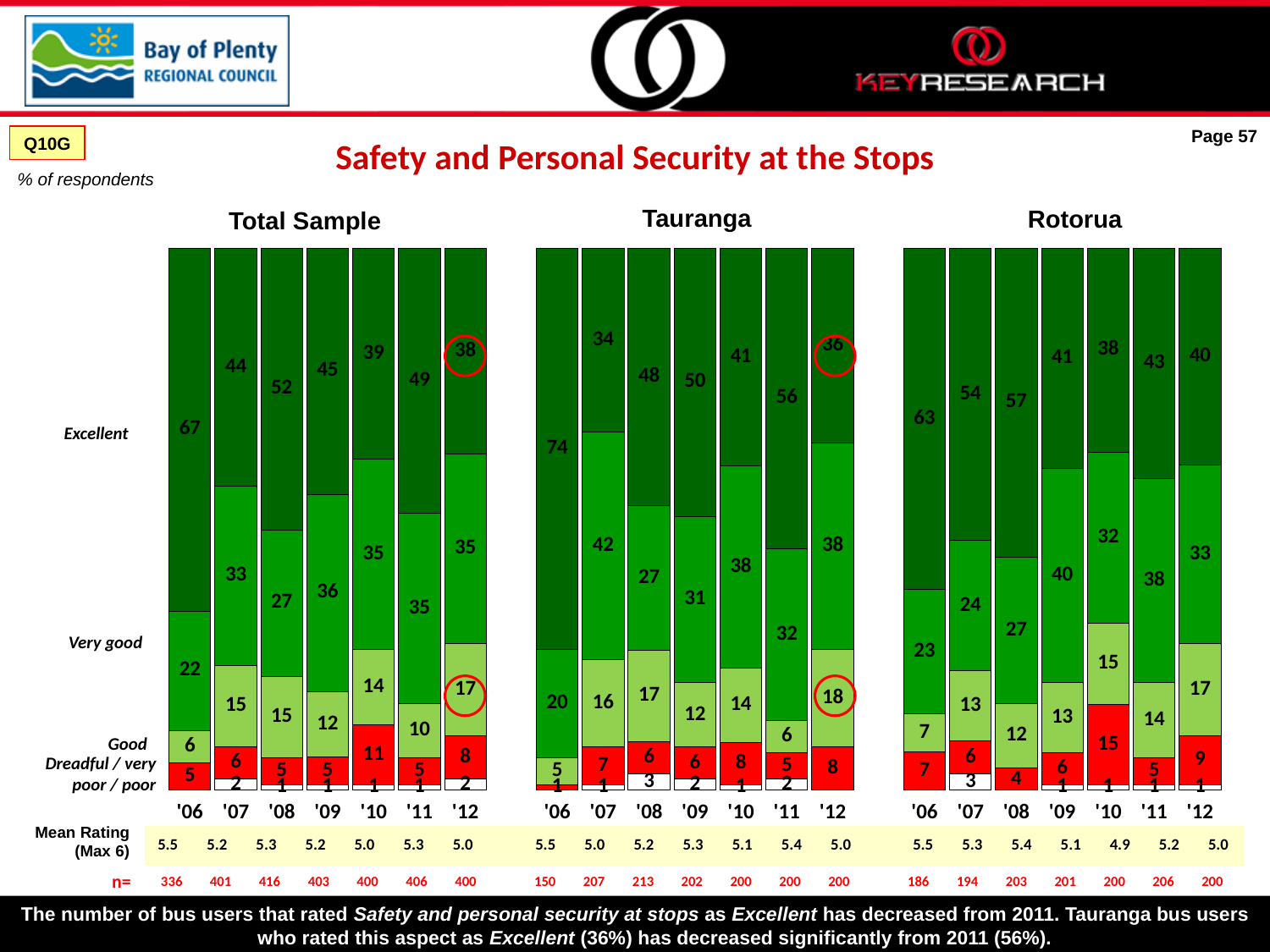
In the Rotorua chart, what is the Mean Rating shown for '10? 4.9 In the Rotorua chart, what is the Very good percentage for '09? 40 In the Rotorua chart, is the Excellent percentage higher in '08 or in '10? '08 In the Tauranga chart, by how many percentage points did the Excellent rating fall from '11 to '12? 20 How many years are shown on the x axis of the Rotorua chart? 7 In the Tauranga chart, what percentage rated safety at the stops as Excellent in '11? 56 In the Tauranga chart, what is the n= value for '06? 150 In the Tauranga chart, which year has the lowest Excellent percentage? '07 In the Total Sample chart, what is the difference between the Good percentage in '12 and in '11? 7 What type of chart is used for the Total Sample? Stacked bar chart In the Total Sample chart, what percentage of respondents rated safety at the stops as Excellent in '12? 38 In the Total Sample chart, which year has the highest Excellent percentage? '06